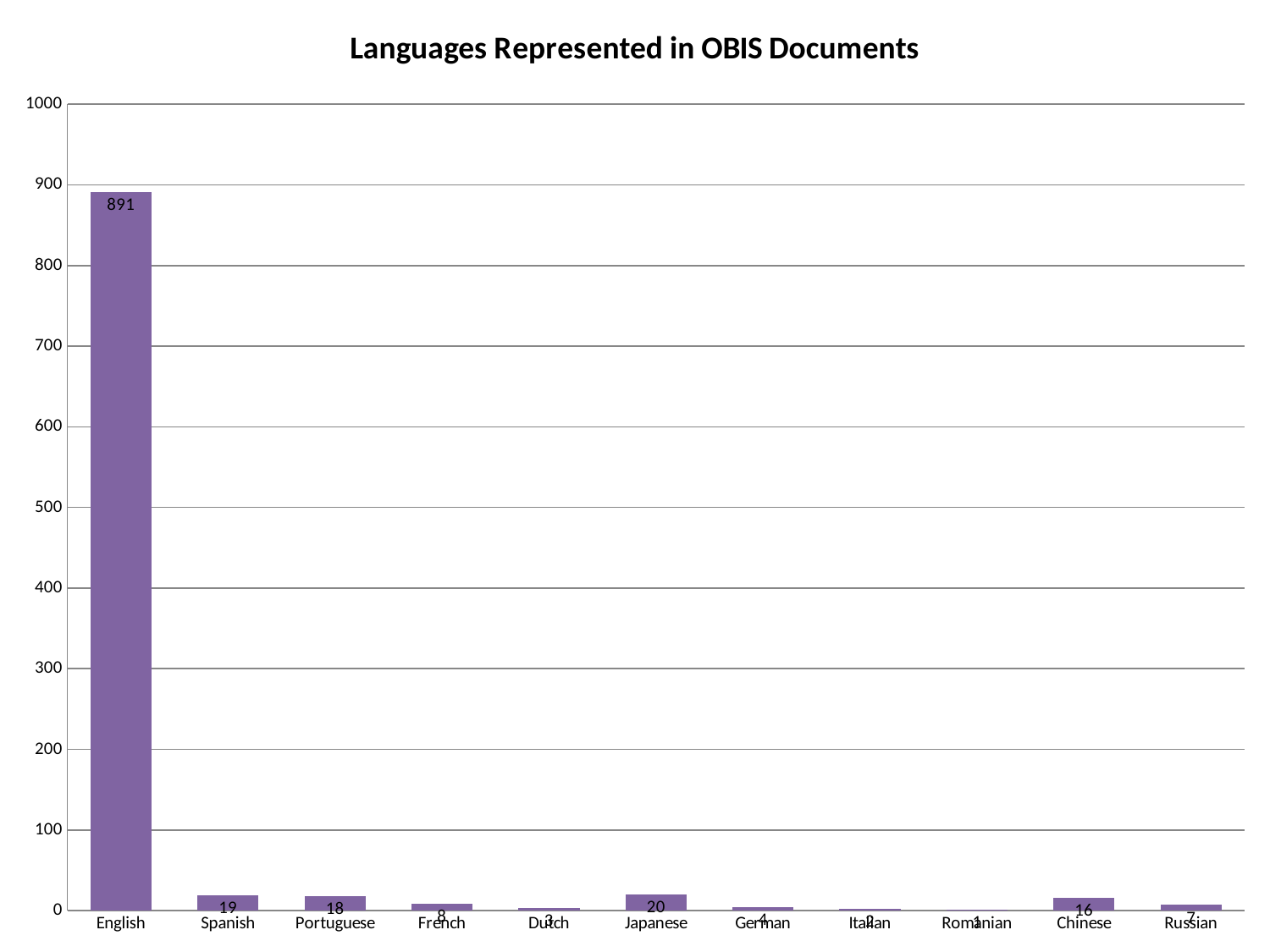
What is the difference between the values for English and Japanese? 871 What is the value for English? 891 Which language has the highest value? English Which is larger, the value for Chinese or the value for French? Chinese What is the value for Chinese? 16 Which language has the lowest value? Romanian What is the value for Japanese? 20 What is the value for Spanish? 19 What is the difference between the values for Spanish and Portuguese? 1 How many languages are shown on the x axis? 11 What kind of chart is shown on the slide? bar chart Is the value for English greater or less than 800? greater